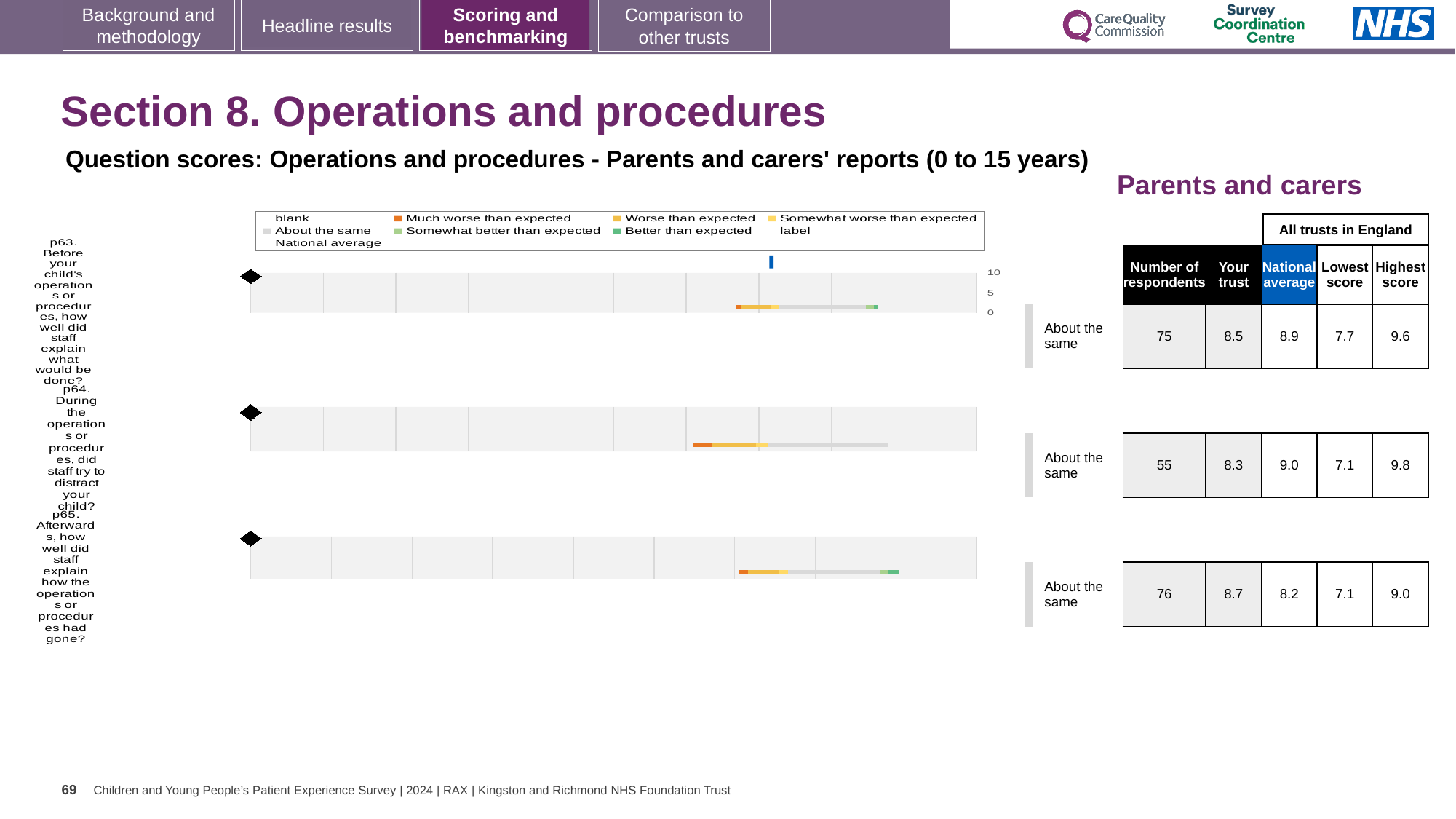
What is the highest score across all trusts in England for p64? 9.8 For p63, which is larger: the 'Your trust' score or the national average? National average How many respondents answered p65 (how well staff explained how the operation had gone)? 76 How many entries does the chart legend list? 9 What is the difference between the highest score and the lowest score for p64? 2.7 Which question has the lowest number of respondents? p64 How many questions (p63, p64, p65) are plotted on the slide? 3 What is the 'Your trust' score for p63 (how well staff explained what would be done before the operation)? 8.5 What benchmark rating is shown for p65? About the same What kind of chart is used to show the question scores on this slide? bar chart Which question has the highest 'Your trust' score? p65 What is the national average score for p64 (did staff try to distract your child during the operation)? 9.0